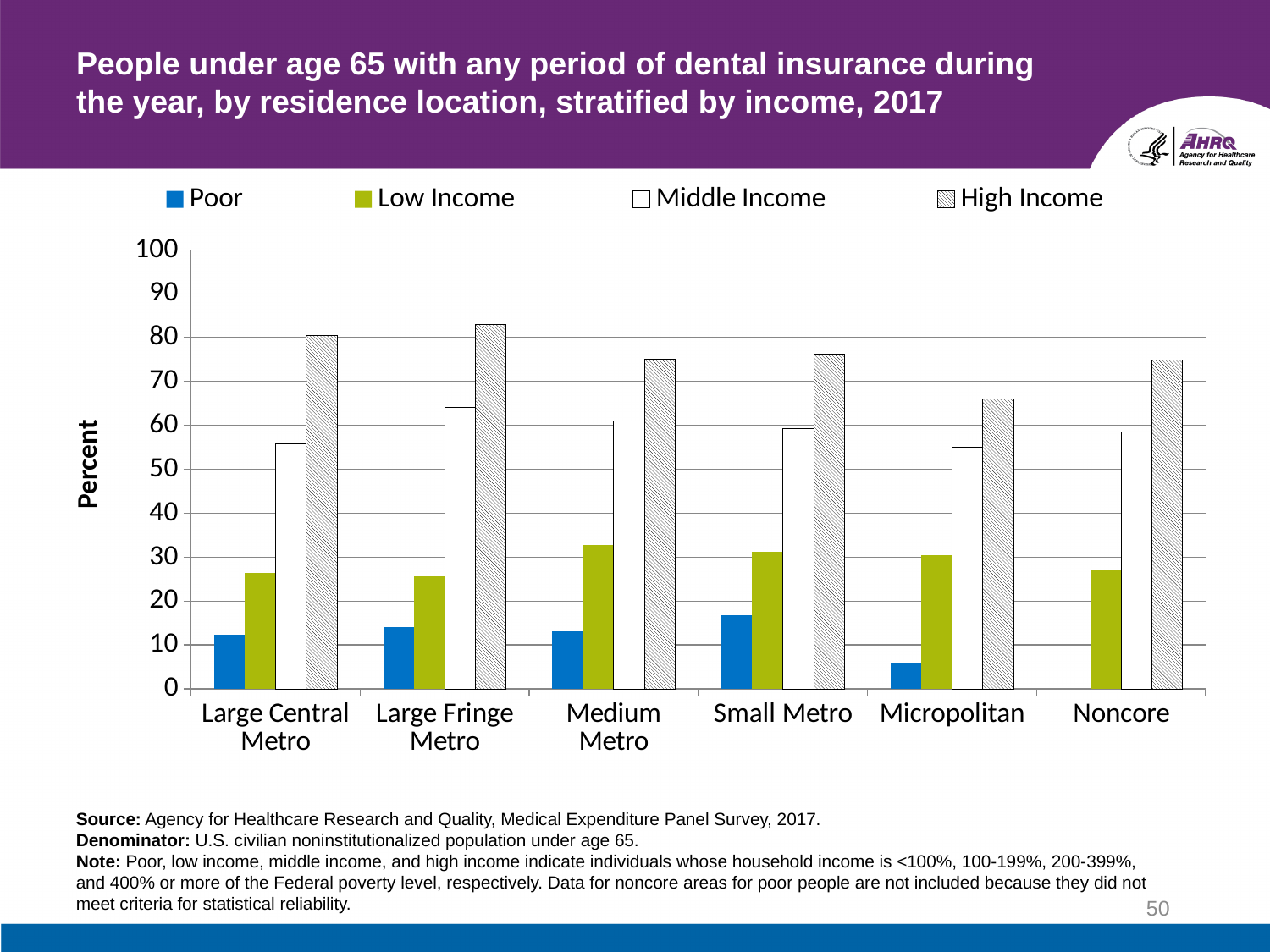
Which residence location has the highest High Income value? Large Fringe Metro Is the High Income value for Large Fringe Metro greater or less than 80? greater Is the Poor value for Micropolitan greater or less than 10? less Which residence location has the highest Poor value? Small Metro How many residence location categories are shown on the x axis? 6 Is the Middle Income value for Large Central Metro greater or less than 60? less Which is larger, the Low Income value for Medium Metro or for Large Fringe Metro? Medium Metro Which residence location has the lowest Poor value among those shown? Micropolitan Which residence location has no Poor bar shown? Noncore Which residence location has the lowest High Income value? Micropolitan How many series does the legend list? 4 What kind of chart is shown on the slide? bar chart